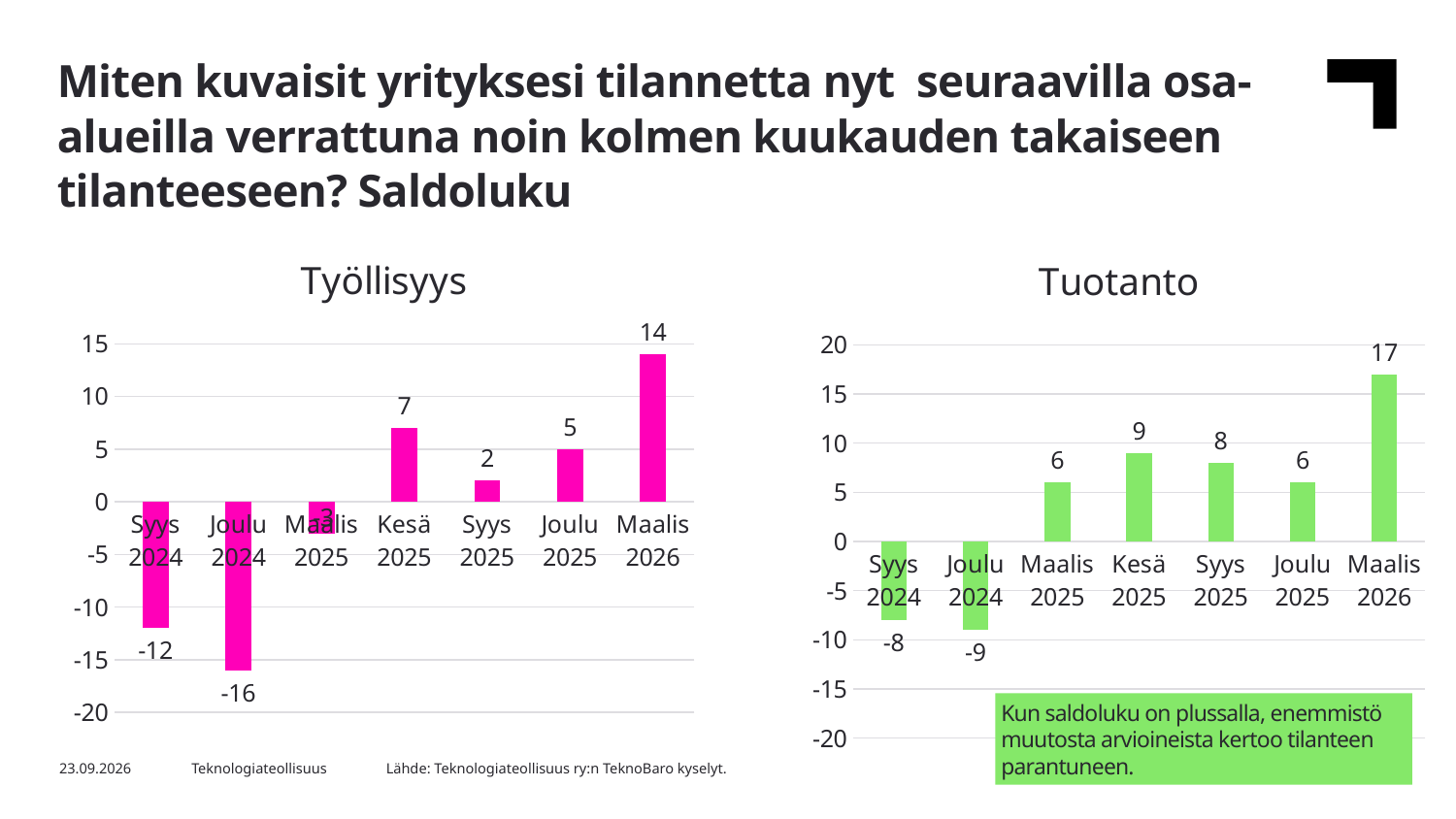
In the Tuotanto chart, is the value for Maalis 2026 greater or less than 15? greater In the Työllisyys chart, which period has the lowest value? Joulu 2024 How many periods are shown on the x axis of the Tuotanto chart? 7 In the Työllisyys chart, which is larger, the value for Kesä 2025 or the value for Joulu 2025? Kesä 2025 In the Tuotanto chart, what is the value for Syys 2024? -8 In the Työllisyys chart, what is the value for Maalis 2026? 14 What colour are the bars in the Tuotanto chart? green In the Tuotanto chart, which period has the highest value? Maalis 2026 In the Tuotanto chart, what is the difference between the values for Maalis 2026 and Syys 2025? 9 In the Tuotanto chart, what is the value for Kesä 2025? 9 What kind of chart is the Työllisyys chart? bar chart In the Työllisyys chart, what is the value for Joulu 2024? -16